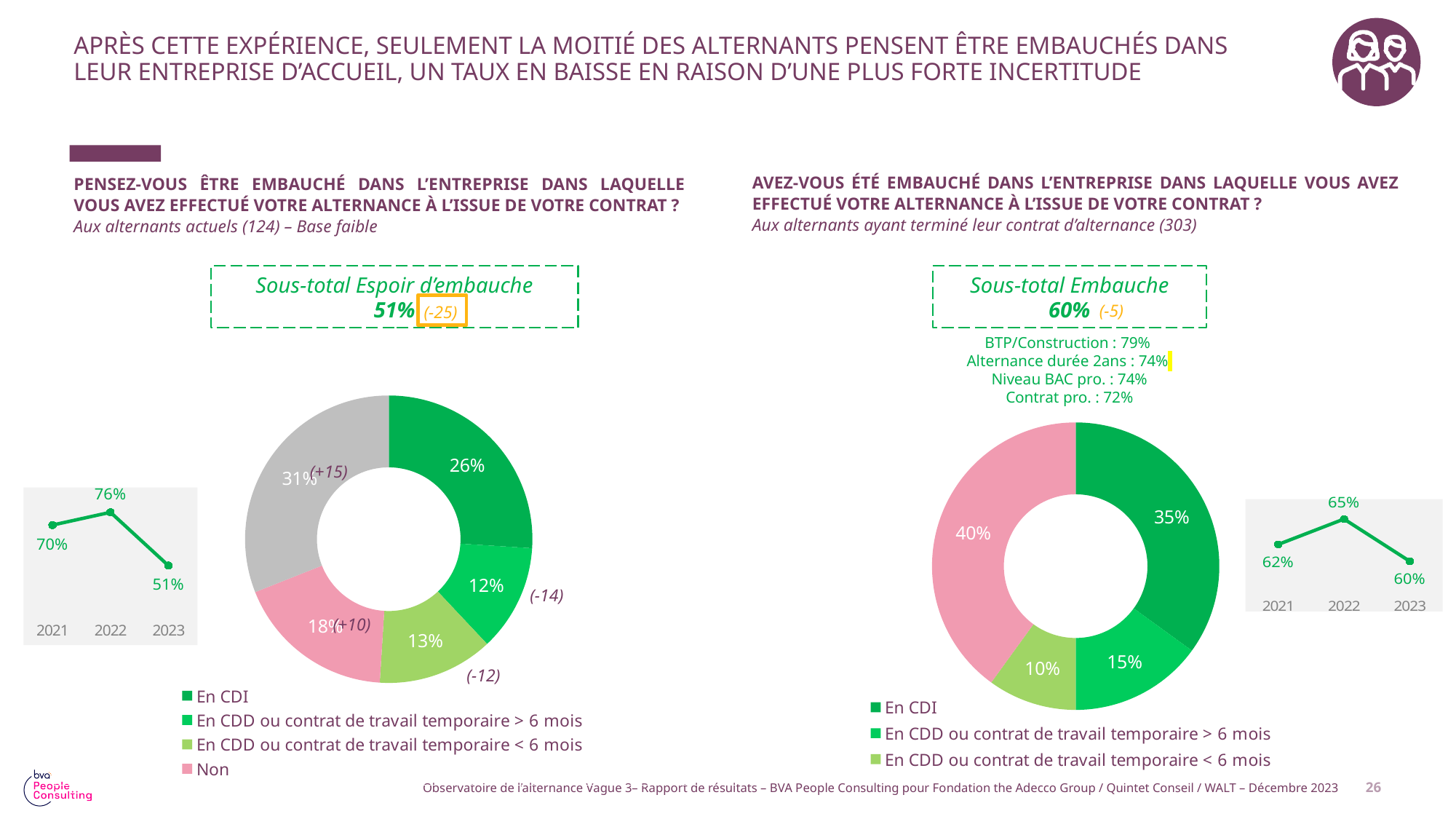
In the right line chart, is the value for 2022 larger or smaller than the value for 2023? larger In the right donut chart, what is the value for 'En CDD ou contrat de travail temporaire > 6 mois'? 15% In the right donut chart, what is the difference between the 'En CDI' share and the 'En CDD ou contrat de travail temporaire < 6 mois' share? 25 points In the right donut chart, what percentage answered 'En CDI'? 35% In the right donut chart, which labelled legend category has the lowest value? En CDD ou contrat de travail temporaire < 6 mois In the right line chart (2021–2023), what is the value for 2021? 62% In the left line chart, which year has the lowest value? 2023 In the left line chart (2021–2023), what is the value for 2022? 76% How many entries does the legend of the left donut chart list? 4 In the left donut chart, what is the value for 'En CDD ou contrat de travail temporaire < 6 mois'? 13% In the left donut chart, what is the value for 'Non'? 18% In the left donut chart, what percentage of current alternants answered 'En CDI'? 26%